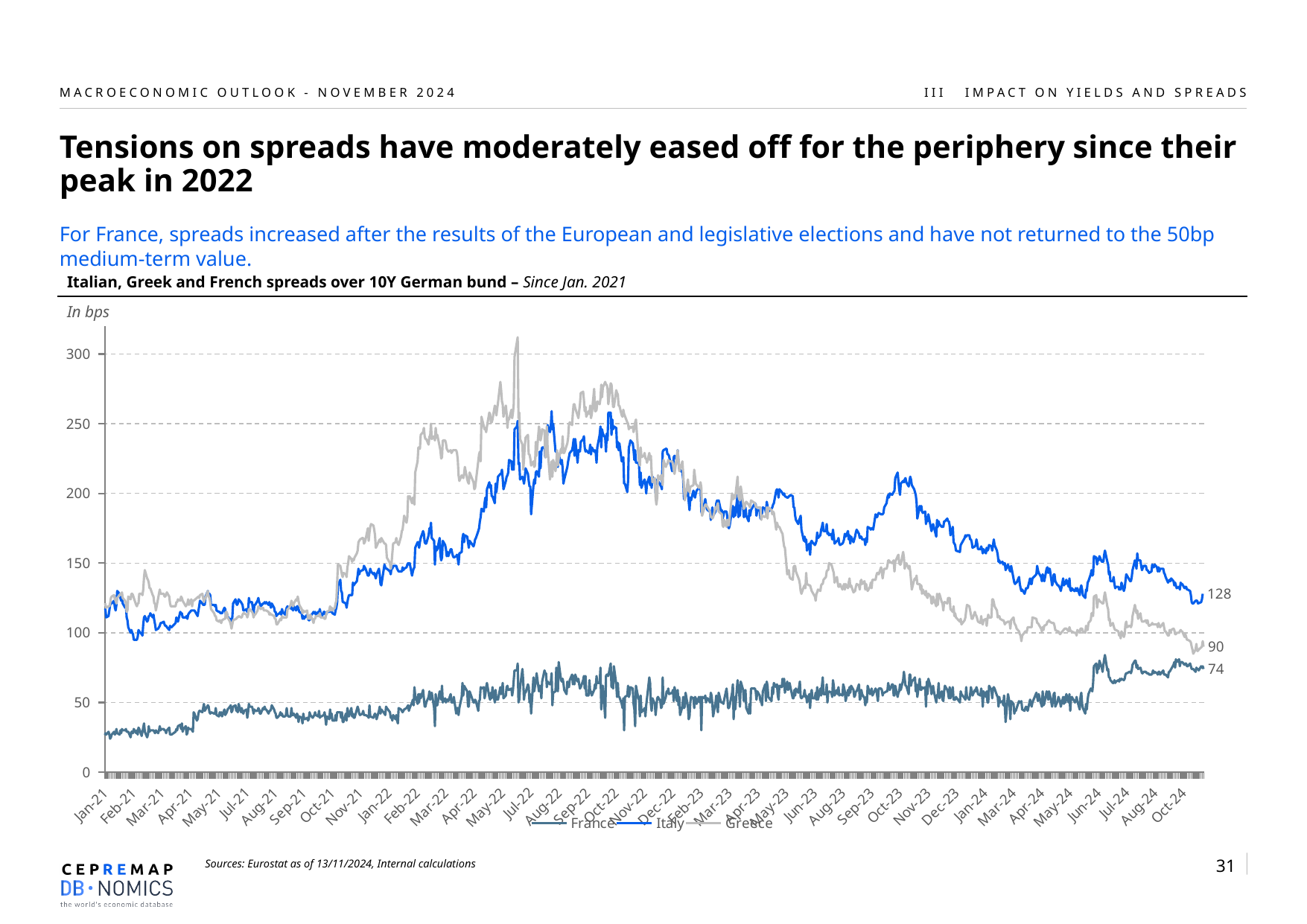
What kind of chart is shown on the slide? line chart At the end of the series, is the spread for Greece larger or smaller than the spread for France? larger Is the value for France in Jan-21 greater or less than 50? less How many series does the legend list? 3 What is the difference between the latest Italy value and the latest Greece value? 38 Which country has the highest spread at the end of the series (Oct-24)? Italy What is the latest value shown for Italy at the right end of the chart? 128 Which country has the lowest spread at the end of the series (Oct-24)? France Is the peak value for Greece in 2022 greater or less than 250? greater What is the latest value shown for Greece at the right end of the chart? 90 What is the latest value shown for France at the right end of the chart? 74 What is the difference between the latest Italy value and the latest France value? 54